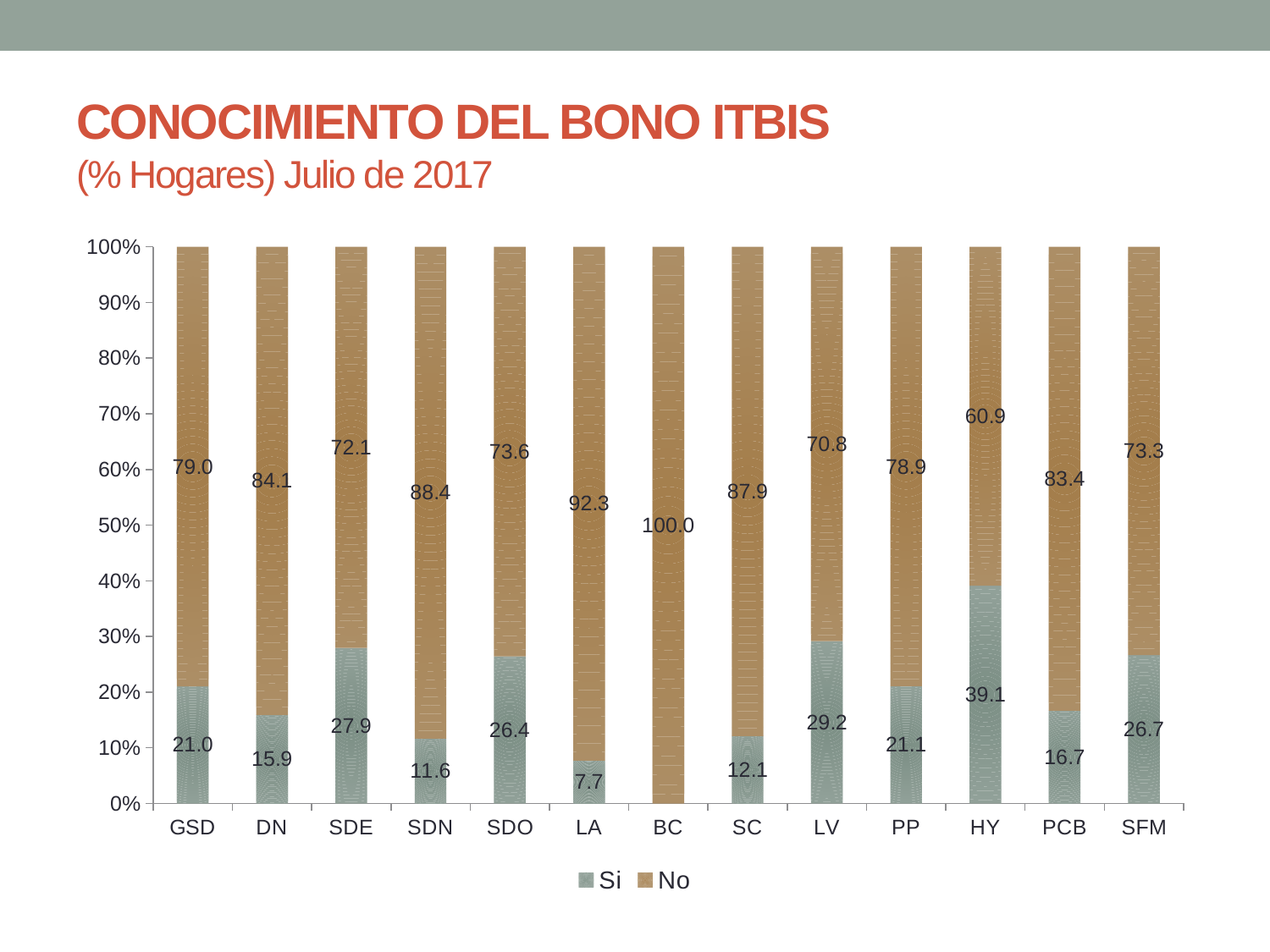
How many categories are shown on the x axis? 13 Which category has the lowest 'Si' value among those with a 'Si' label? LA What is the 'No' value for LA? 92.3 Which is larger, the 'Si' value for LV or the 'Si' value for SDO? LV Which category has the highest 'Si' value? HY What kind of chart is shown? Stacked bar chart What is the 'Si' value for GSD? 21.0 What is the 'Si' value for HY? 39.1 What is the title of the chart? CONOCIMIENTO DEL BONO ITBIS How many series does the legend list? 2 What is the difference between the 'No' values for SC and SDE? 15.8 Which category has the highest 'No' value? BC